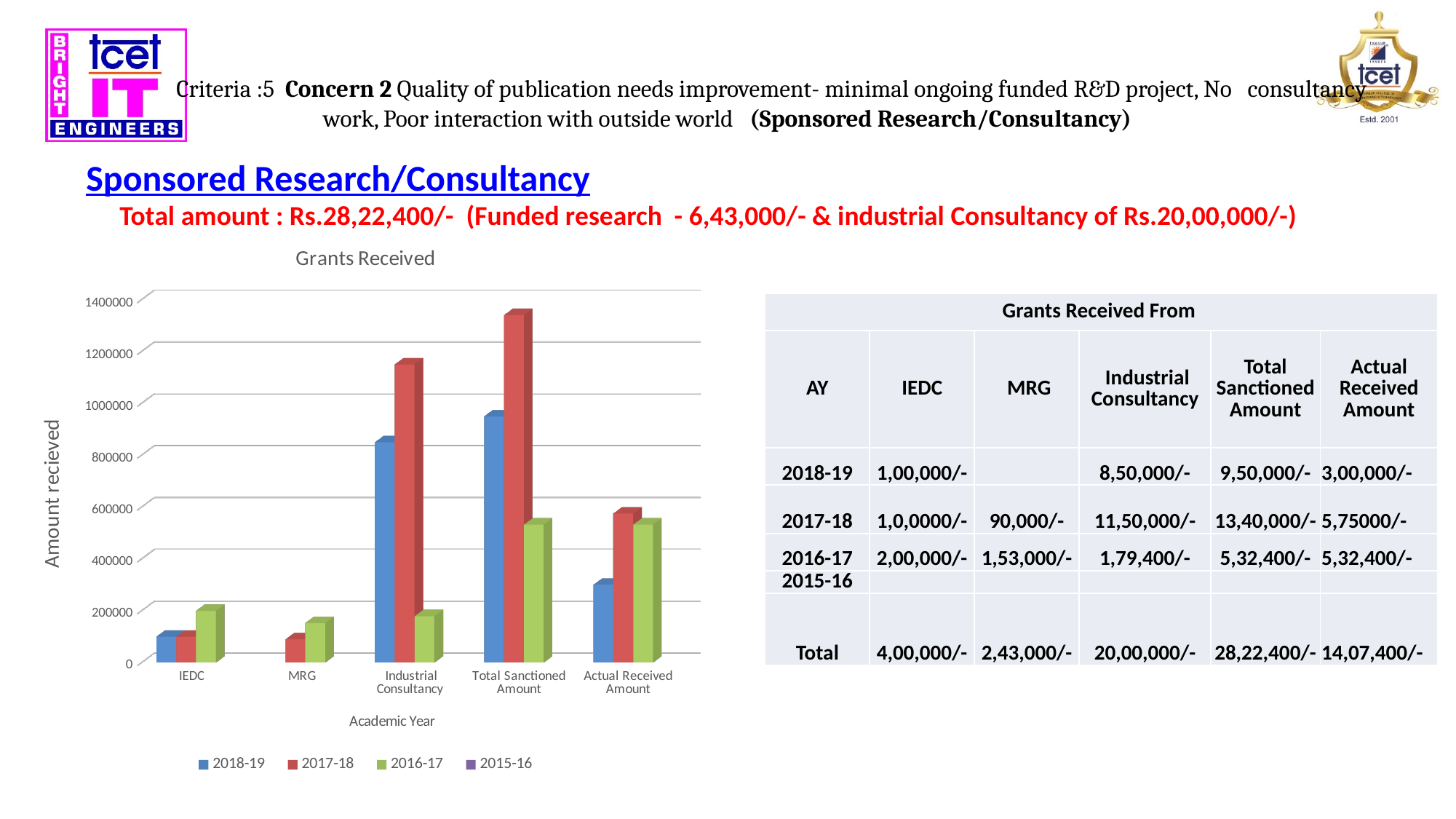
How many series does the chart legend list? 4 Which series has the lowest bar for Actual Received Amount? 2018-19 What is the title of the chart? Grants Received Is the 2017-18 value for Total Sanctioned Amount greater or less than 1200000? greater What kind of chart is shown on the slide? bar chart Which category has the tallest bar in the chart? Total Sanctioned Amount What label is shown on the y axis of the chart? Amount recieved Which series has the highest bar for Total Sanctioned Amount? 2017-18 Which series has the highest bar for IEDC? 2016-17 How many categories are shown along the x axis of the chart? 5 Is the 2018-19 value for Actual Received Amount greater or less than 400000? less Which is larger for Industrial Consultancy, the 2018-19 bar or the 2017-18 bar? 2017-18